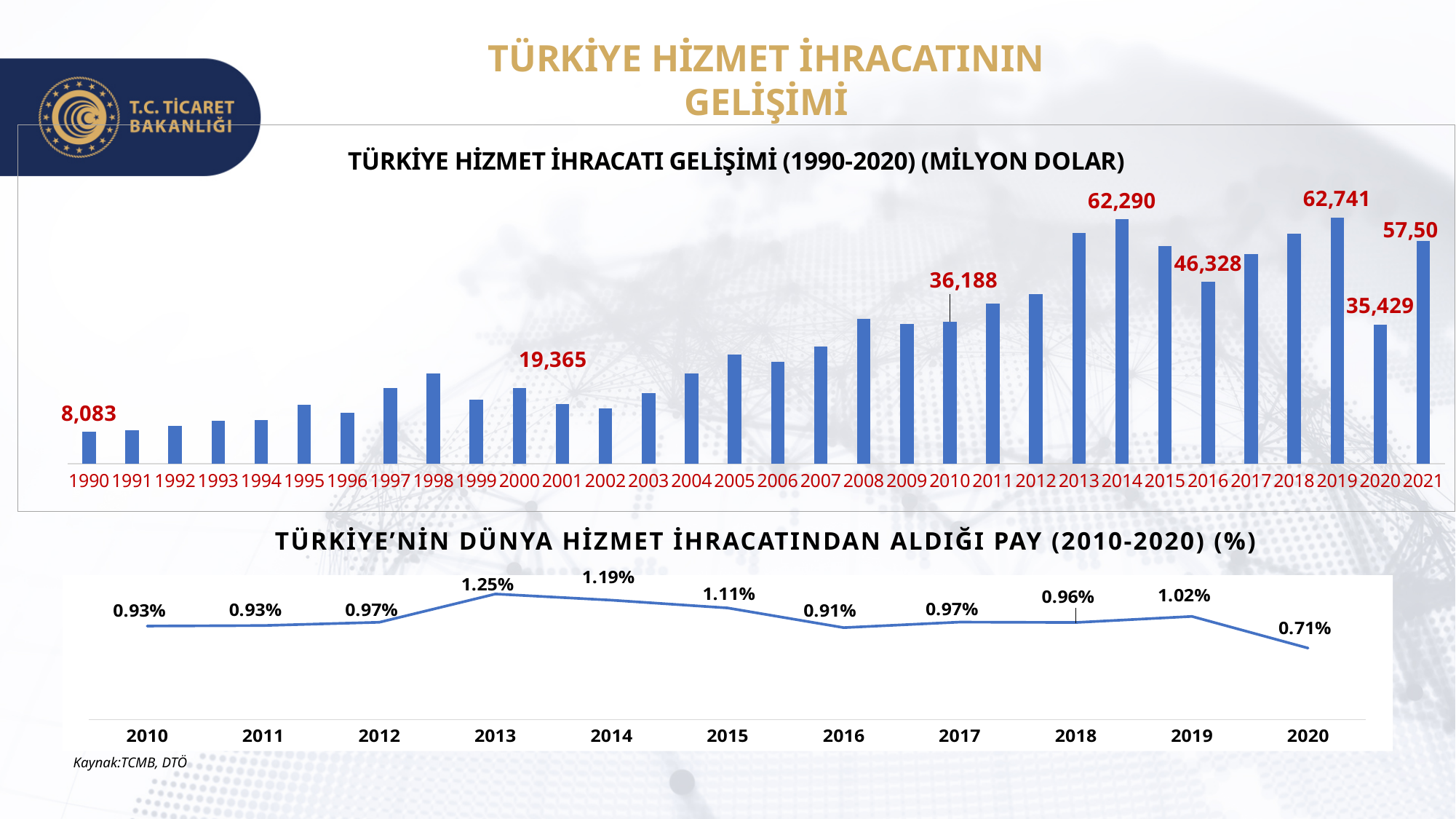
In the bottom chart (TÜRKİYE'NİN DÜNYA HİZMET İHRACATINDAN ALDIĞI PAY), what is the difference between the 2019 value and the 2020 value? 0.31% In the top chart (TÜRKİYE HİZMET İHRACATI GELİŞİMİ), what is the value for 2014? 62,290 In the bottom chart (TÜRKİYE'NİN DÜNYA HİZMET İHRACATINDAN ALDIĞI PAY), how many years are plotted? 11 In the top chart (TÜRKİYE HİZMET İHRACATI GELİŞİMİ), what is the difference between the 2010 value and the 2000 value? 16,823 In the top chart (TÜRKİYE HİZMET İHRACATI GELİŞİMİ), which year has the highest value? 2019 In the top chart (TÜRKİYE HİZMET İHRACATI GELİŞİMİ), what kind of chart is it? bar chart In the bottom chart (TÜRKİYE'NİN DÜNYA HİZMET İHRACATINDAN ALDIĞI PAY), which year has the lowest value? 2020 In the bottom chart (TÜRKİYE'NİN DÜNYA HİZMET İHRACATINDAN ALDIĞI PAY), what is the value for 2013? 1.25% In the top chart (TÜRKİYE HİZMET İHRACATI GELİŞİMİ), which is larger, the value for 2010 or the value for 2020? 2010 In the top chart (TÜRKİYE HİZMET İHRACATI GELİŞİMİ), which year has the lowest value? 1990 In the bottom chart (TÜRKİYE'NİN DÜNYA HİZMET İHRACATINDAN ALDIĞI PAY), what kind of chart is it? line chart In the top chart (TÜRKİYE HİZMET İHRACATI GELİŞİMİ), what is the value for 1990? 8,083